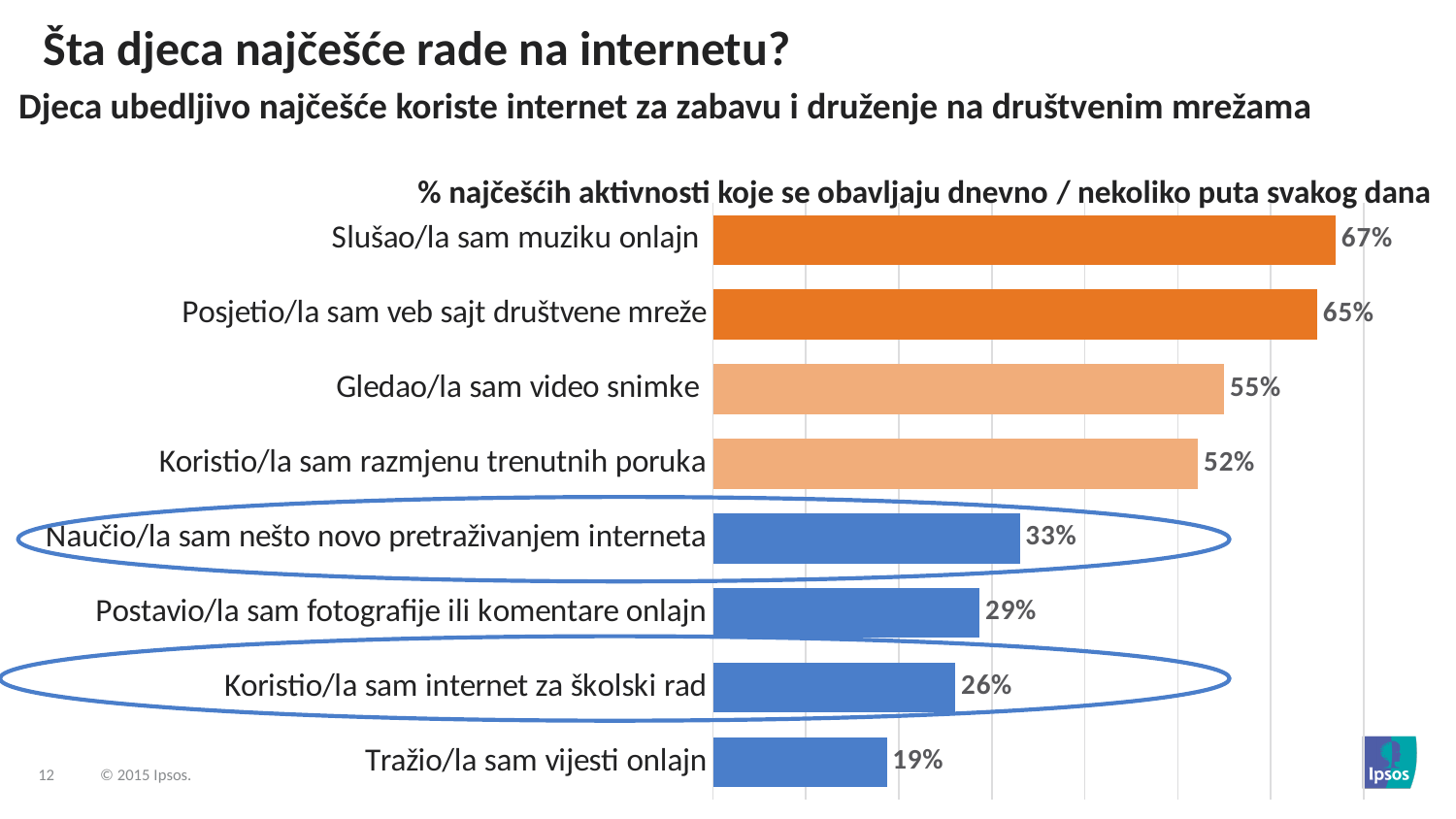
What kind of chart is shown on the slide? Bar chart Which two activities are circled on the chart? Naučio/la sam nešto novo pretraživanjem interneta; Koristio/la sam internet za školski rad What is the difference between "Slušao/la sam muziku onlajn" and "Tražio/la sam vijesti onlajn"? 48% How many activities are shown in the chart? 8 What is the value for "Slušao/la sam muziku onlajn"? 67% Which is larger: "Postavio/la sam fotografije ili komentare onlajn" or "Koristio/la sam internet za školski rad"? Postavio/la sam fotografije ili komentare onlajn Which activity has the lowest value? Tražio/la sam vijesti onlajn Which activity has the highest value? Slušao/la sam muziku onlajn What is the value for "Naučio/la sam nešto novo pretraživanjem interneta"? 33% What is the difference between "Gledao/la sam video snimke" and "Koristio/la sam razmjenu trenutnih poruka"? 3% What is the value for "Koristio/la sam internet za školski rad"? 26% What is the title of the chart? % najčešćih aktivnosti koje se obavljaju dnevno / nekoliko puta svakog dana